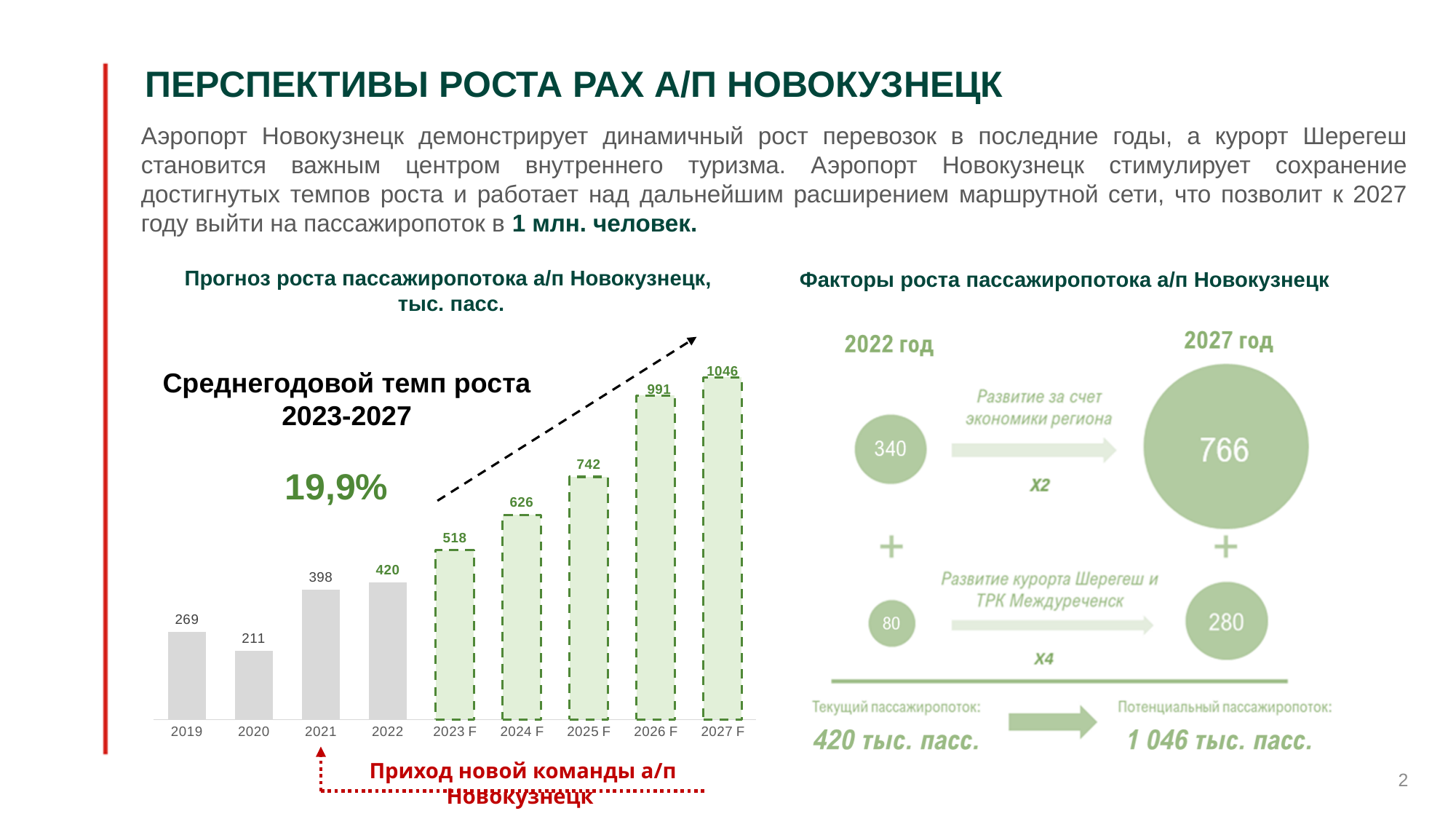
In the bar chart 'Прогноз роста пассажиропотока а/п Новокузнецк', what is the difference between the values for 2026 F and 2025 F? 249 Which year has the highest value in the bar chart 'Прогноз роста пассажиропотока а/п Новокузнецк'? 2027 F How many years (bars) are shown in the bar chart 'Прогноз роста пассажиропотока а/п Новокузнецк'? 9 What is the value for 2022 in the bar chart 'Прогноз роста пассажиропотока а/п Новокузнецк'? 420 What is the value for 2020 in the bar chart 'Прогноз роста пассажиропотока а/п Новокузнецк'? 211 What kind of chart is 'Прогноз роста пассажиропотока а/п Новокузнецк'? Bar chart In the bar chart 'Прогноз роста пассажиропотока а/п Новокузнецк', which is larger: the value for 2019 or the value for 2020? 2019 In the bar chart 'Прогноз роста пассажиропотока а/п Новокузнецк', what is the difference between the values for 2021 and 2019? 129 What is the value for 2027 F in the bar chart 'Прогноз роста пассажиропотока а/п Новокузнецк'? 1046 Which year has the lowest value in the bar chart 'Прогноз роста пассажиропотока а/п Новокузнецк'? 2020 In the bar chart 'Прогноз роста пассажиропотока а/п Новокузнецк', do the values rise or fall from 2021 to 2027 F? Rise What average annual growth rate for 2023-2027 is stated on the bar chart 'Прогноз роста пассажиропотока а/п Новокузнецк'? 19,9%